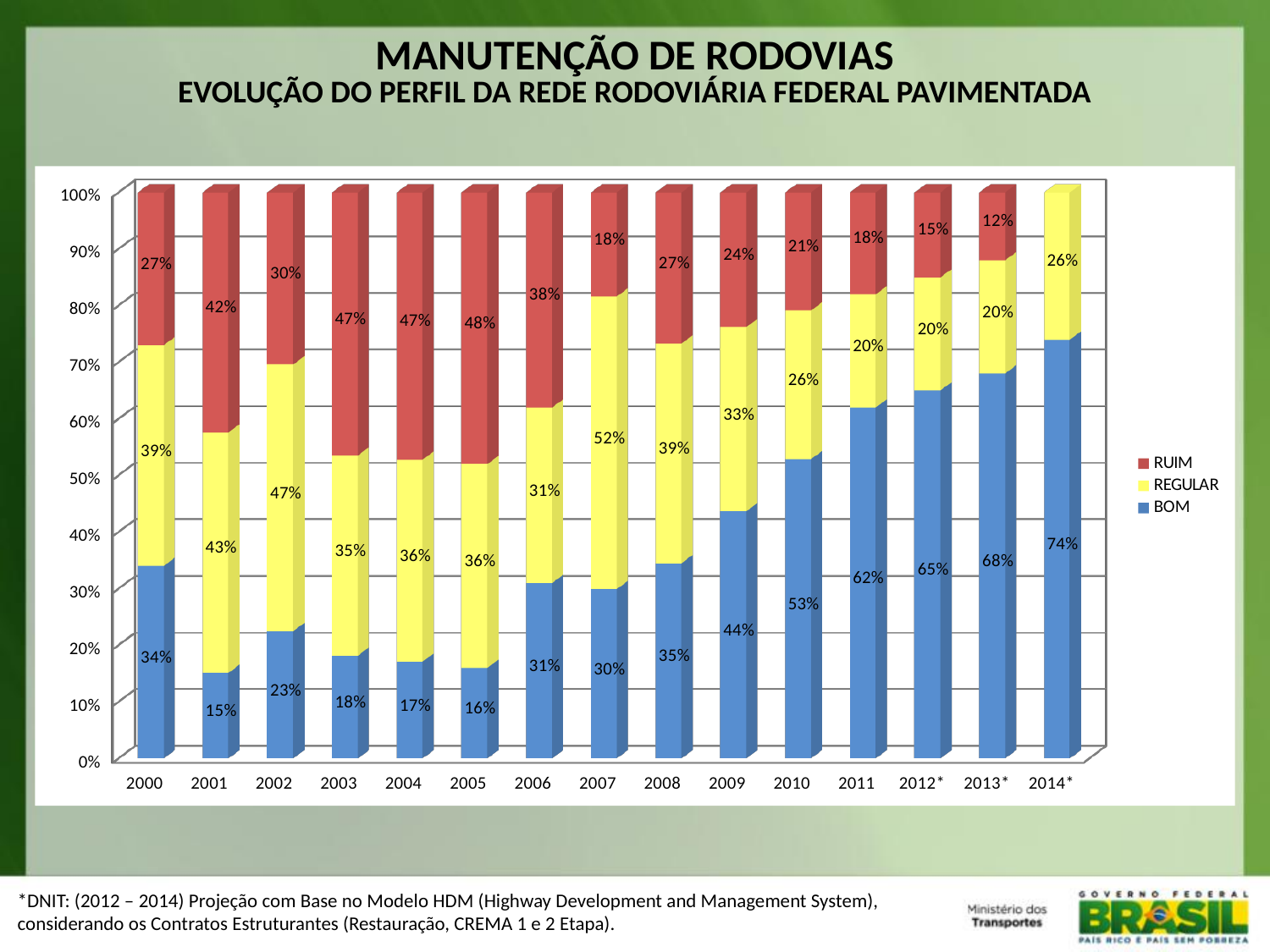
What is the BOM share projected for 2014*? 74% What kind of chart is shown on the slide? Stacked bar chart What is the REGULAR share in 2007? 52% In which year is the BOM share the highest? 2014* Does the BOM share rise or fall from 2005 to 2014*? Rise How many series does the legend list? 3 What percentage of the network is classified as BOM in 2000? 34% What is the difference between the BOM share in 2011 and in 2001? 47 percentage points In which year is the BOM share the lowest? 2001 How many years are shown on the x axis? 15 Which is larger in 2003: the RUIM share or the REGULAR share? RUIM What is the RUIM share in 2005? 48%